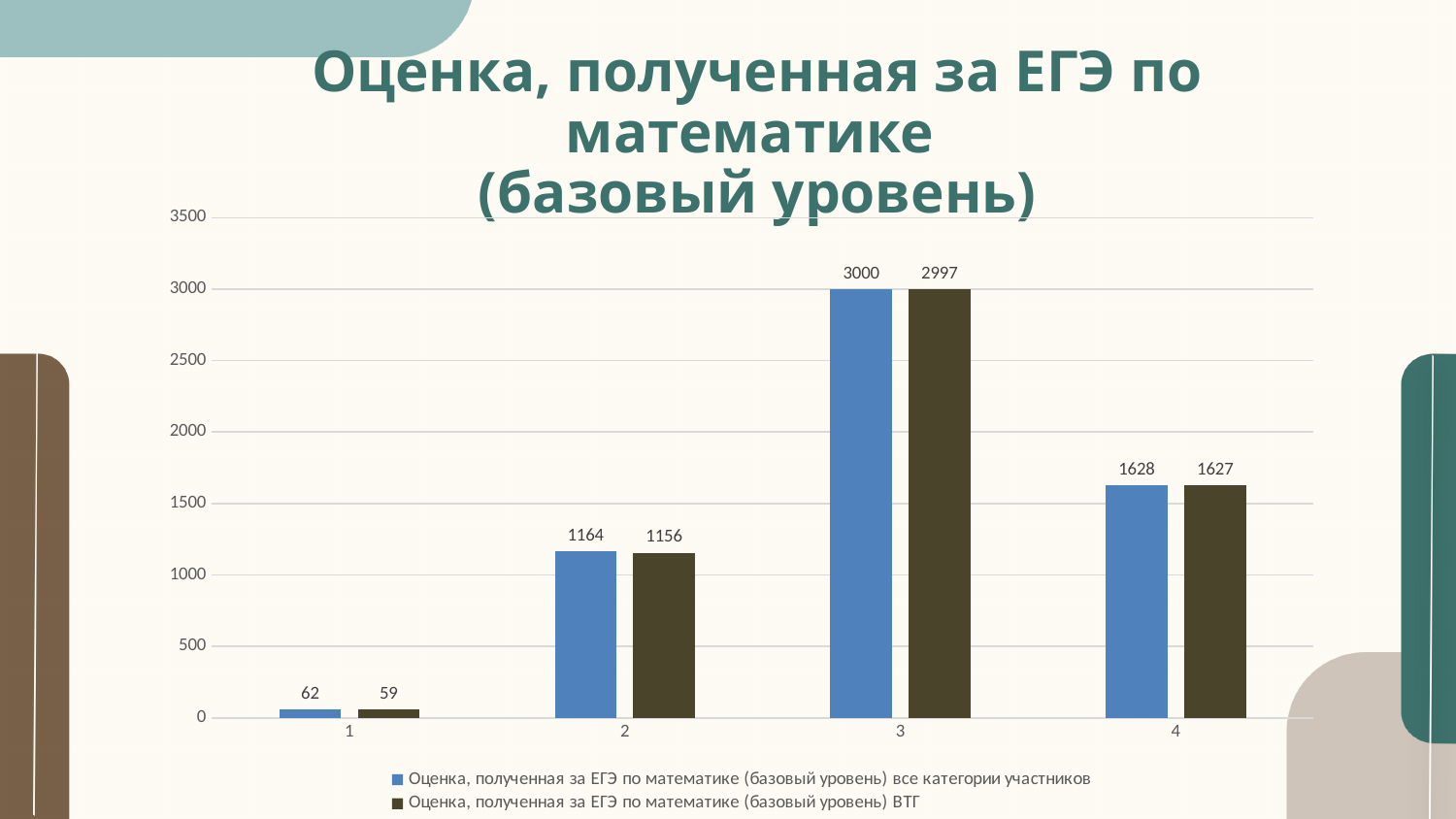
How many series does the legend list? 2 What is the difference between the 'все категории участников' and 'ВТГ' values for category 2? 8 What is the value for category 2 in the series 'ВТГ'? 1156 Which category has the highest value in the series 'ВТГ'? 3 What is the value for category 3 in the series 'все категории участников'? 3000 What kind of chart is shown on the slide? bar chart Which category has the lowest value in the series 'все категории участников'? 1 How many categories are shown on the x axis? 4 What colour are the bars for the series 'ВТГ'? dark brown What is the value for category 1 in the series 'все категории участников'? 62 What is the value for category 4 in the series 'ВТГ'? 1627 Which is larger: the 'все категории участников' value for category 4 or for category 2? category 4